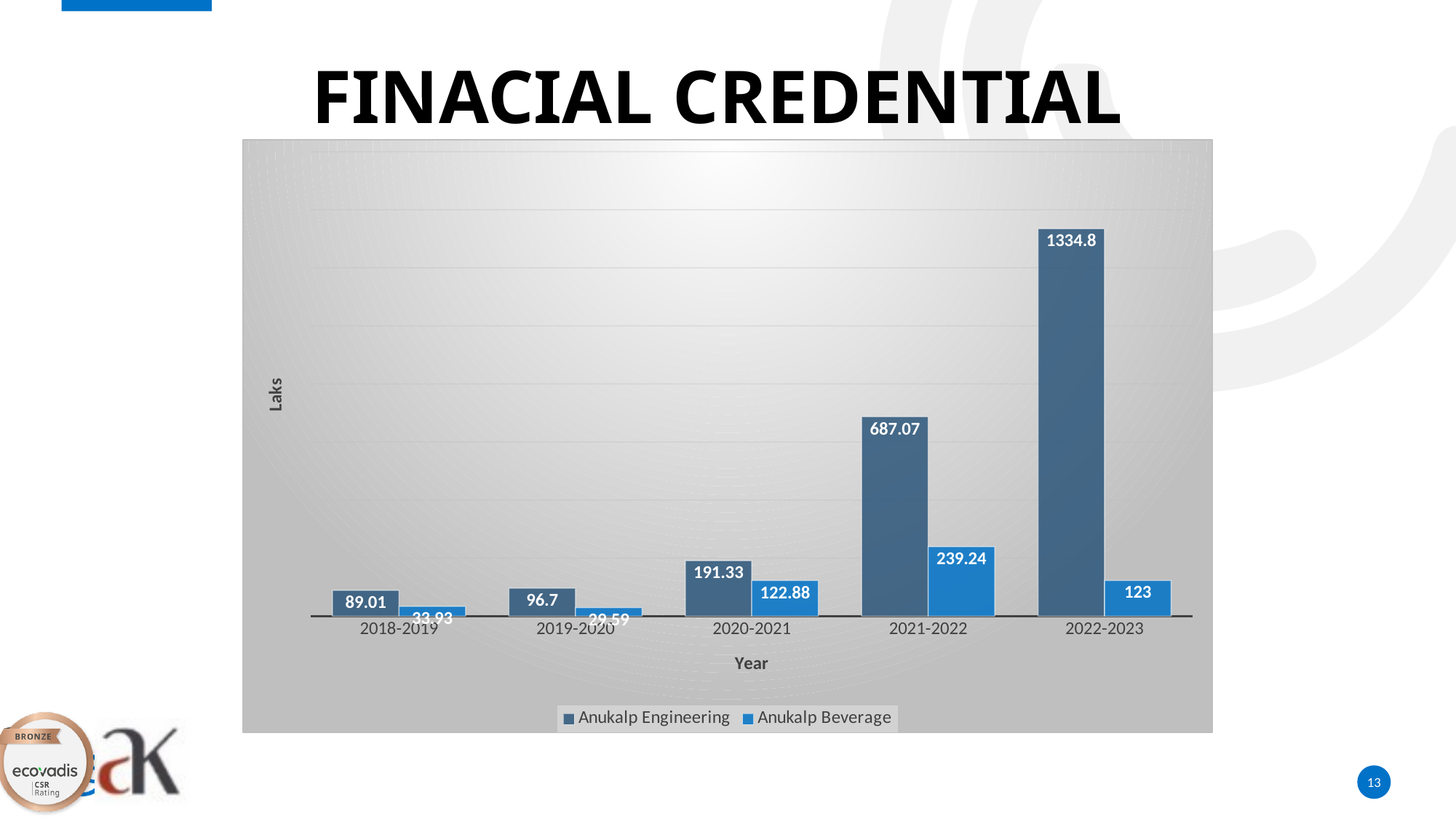
Which is larger in 2020-2021, Anukalp Engineering or Anukalp Beverage? Anukalp Engineering How many series does the legend list? 2 Does the Anukalp Engineering value rise or fall from 2018-2019 to 2022-2023? Rise What is the value for Anukalp Engineering in 2020-2021? 191.33 What type of chart is shown on the slide? Bar chart How many year categories are shown on the x axis? 5 What is the value for Anukalp Beverage in 2022-2023? 123 In which year is the Anukalp Beverage value highest? 2021-2022 What is the difference between Anukalp Engineering and Anukalp Beverage in 2021-2022? 447.83 What is the value for Anukalp Beverage in 2021-2022? 239.24 What is the value for Anukalp Engineering in 2022-2023? 1334.8 In which year is the Anukalp Engineering value highest? 2022-2023